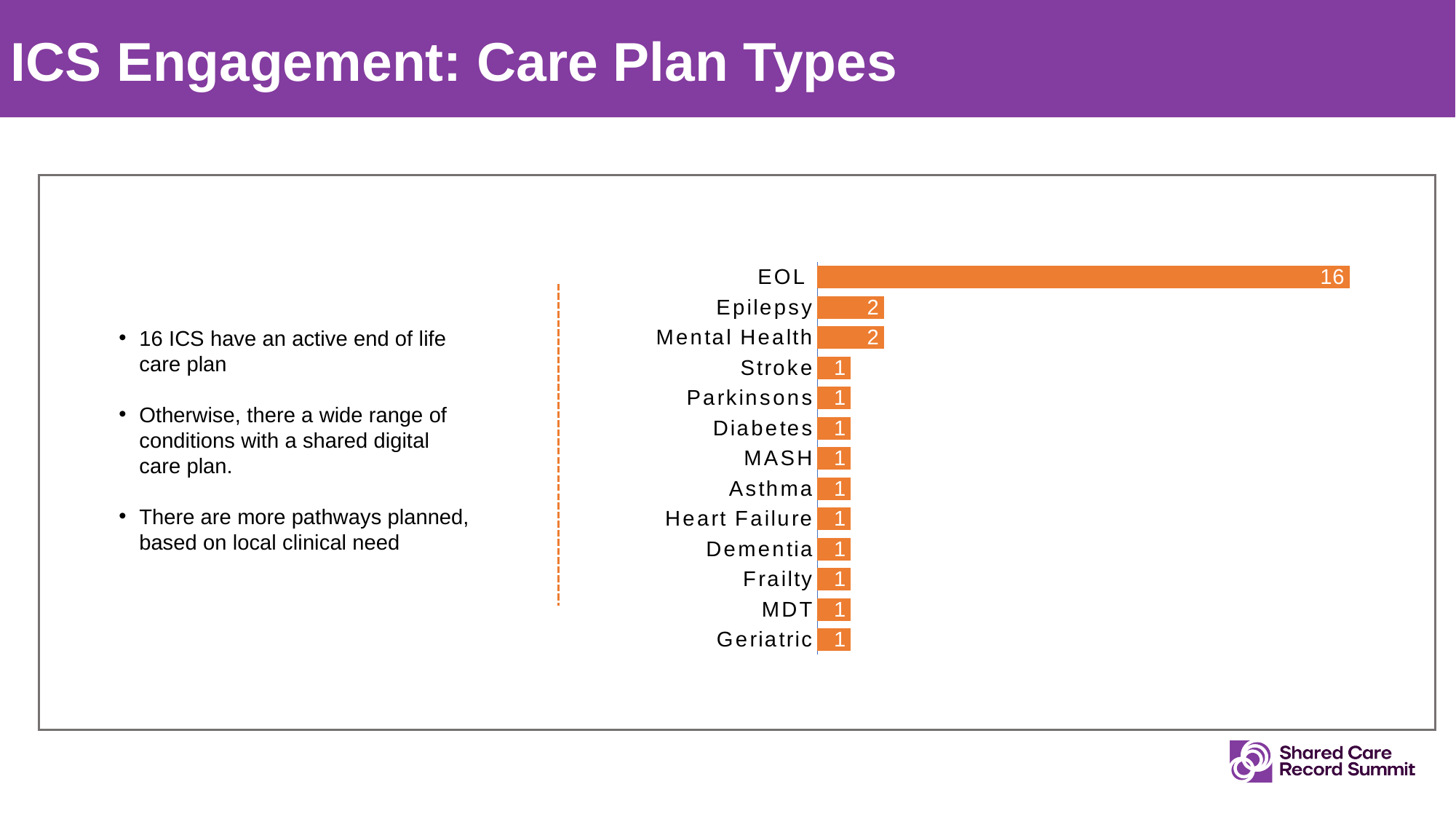
What is the difference between the values for Mental Health and Stroke? 1 Which category has the highest value? EOL What colour are the bars in the chart? Orange What is the value for Mental Health? 2 What is the value for Dementia? 1 What kind of chart is shown on the slide? Bar chart What is the value for Epilepsy? 2 What is the difference between the values for EOL and Epilepsy? 14 Which is larger, the value for Epilepsy or the value for Frailty? Epilepsy How many categories are shown in the chart? 13 What is the value for EOL? 16 Which is larger, the value for EOL or the value for Mental Health? EOL